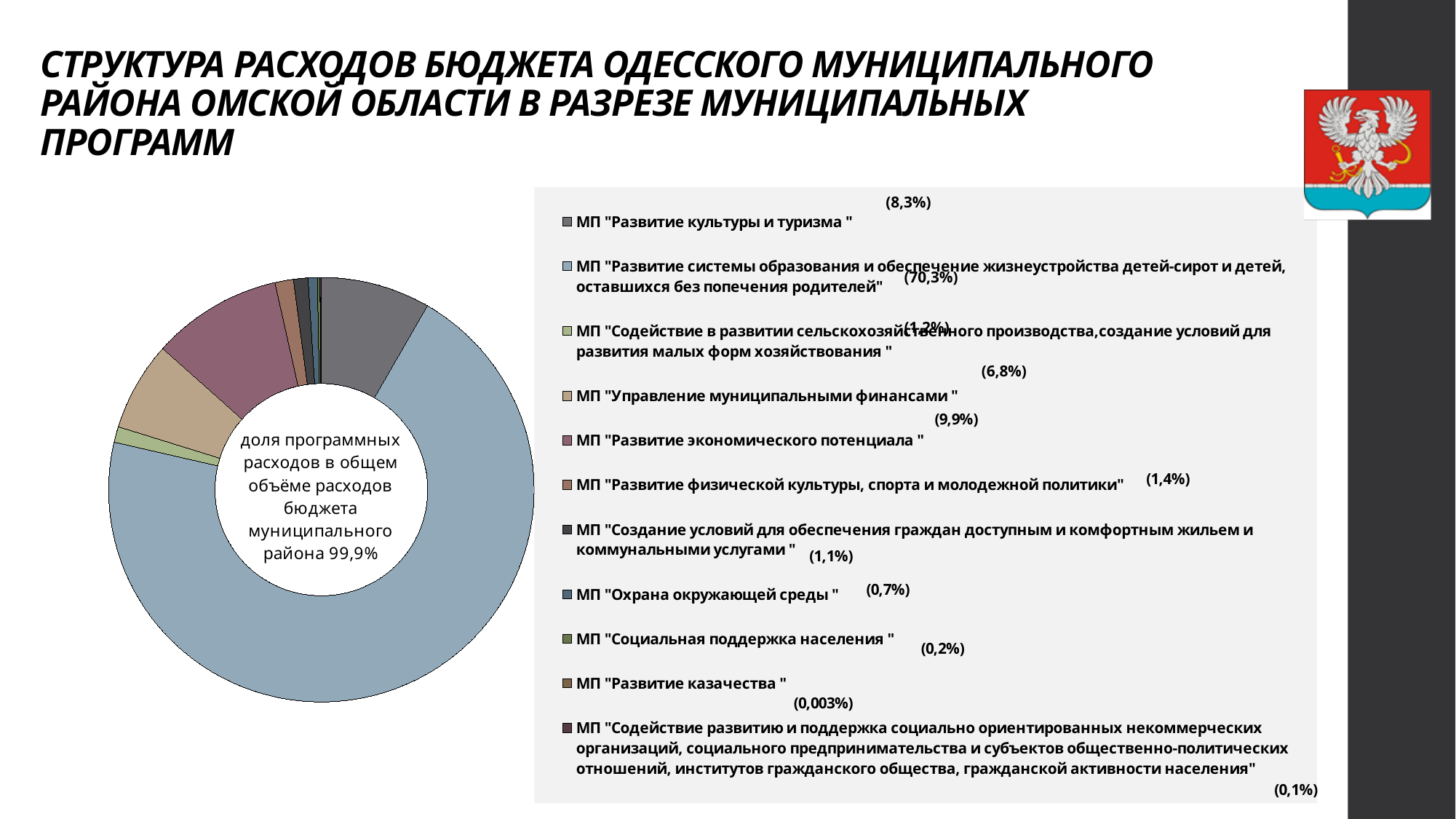
What share of expenditure goes to МП "Развитие экономического потенциала"? 9,9% Which has a larger share: МП "Развитие экономического потенциала" or МП "Управление муниципальными финансами"? МП "Развитие экономического потенциала" What share of expenditure goes to МП "Управление муниципальными финансами"? 6,8% According to the text in the centre of the chart, what is the share of programme expenditure in the total budget expenditure of the municipal district? 99,9% How many municipal programmes does the legend list? 11 Which municipal programme has the largest share of budget expenditure? МП "Развитие системы образования и обеспечение жизнеустройства детей-сирот и детей, оставшихся без попечения родителей" What share of expenditure goes to МП "Развитие культуры и туризма"? 8,3% By how many percentage points does the share of МП "Развитие экономического потенциала" exceed that of МП "Управление муниципальными финансами"? 3,1 What share of expenditure goes to МП "Развитие системы образования и обеспечение жизнеустройства детей-сирот и детей, оставшихся без попечения родителей"? 70,3% What share of expenditure goes to МП "Развитие казачества"? 0,003% Which municipal programme has the smallest share of expenditure? МП "Развитие казачества" What kind of chart is shown on the slide? Pie (doughnut) chart